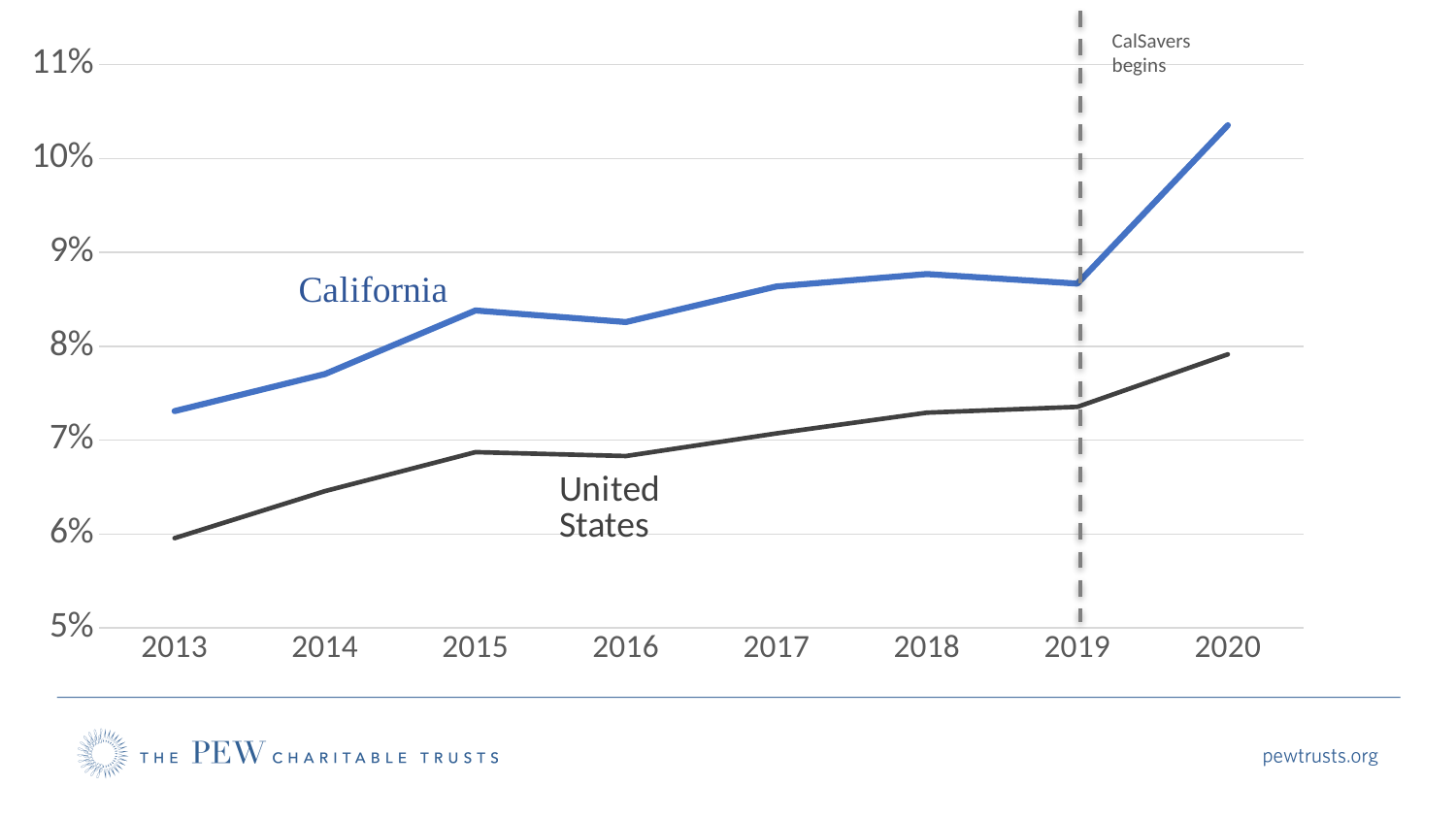
What kind of chart is shown on the slide? line chart In which year does the California line reach its highest value? 2020 How many series are plotted on the chart? 2 Is the value for United States in 2020 greater or less than 8%? less What event does the dashed vertical line at 2019 mark? CalSavers begins In which year is the United States line at its lowest value? 2013 How many years are shown on the x axis? 8 Is the value for California in 2020 greater or less than 10%? greater Is the value for California in 2019 greater or less than 9%? less Does the United States line generally rise or fall from 2013 to 2020? rise Which series has the higher value in 2020, California or United States? California